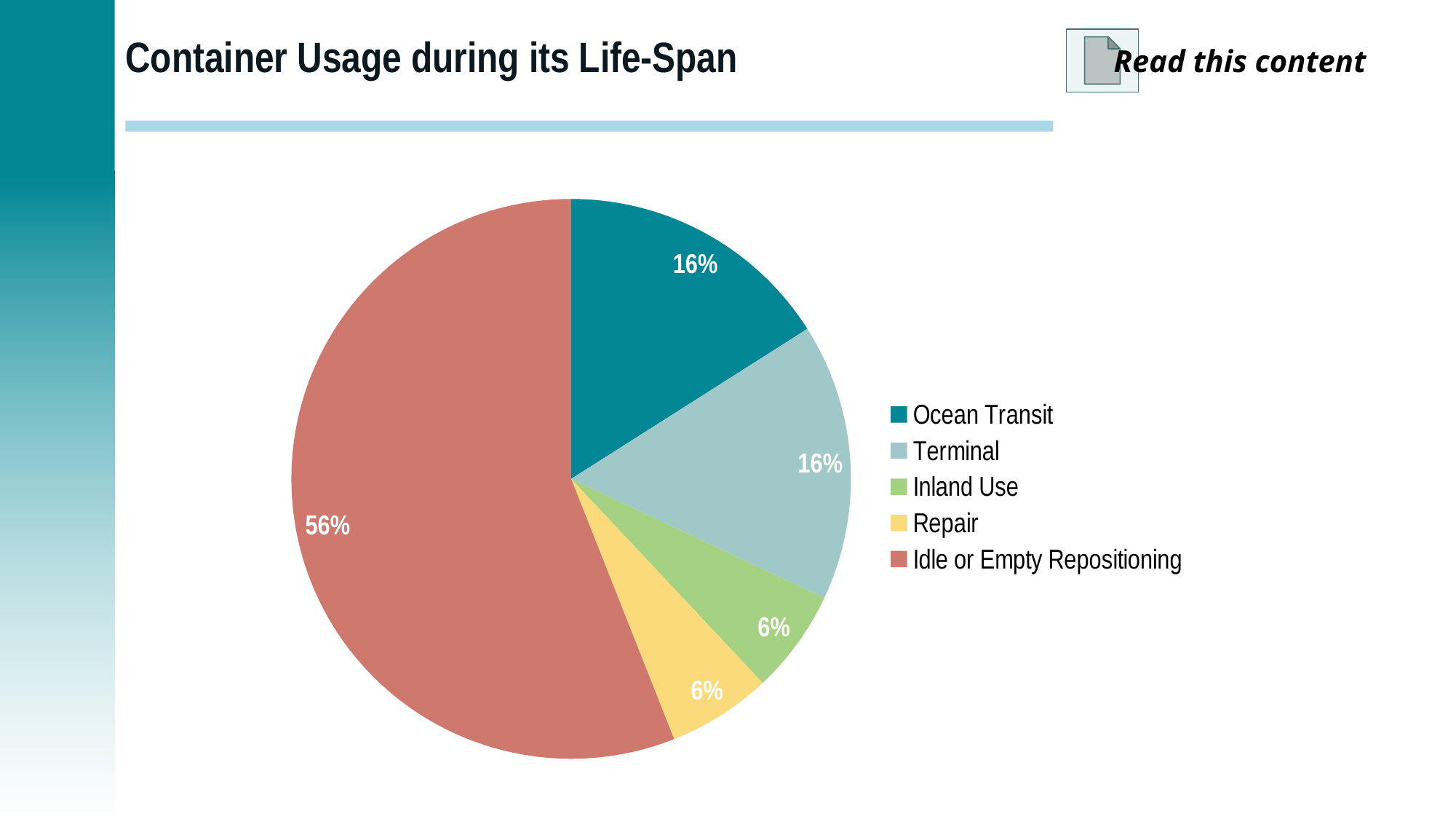
What share of container usage is Idle or Empty Repositioning? 56% How many categories does the pie chart show? 5 What kind of chart is shown on the slide? Pie chart Which is larger, the share for Ocean Transit or the share for Repair? Ocean Transit What share of container usage is Ocean Transit? 16% What is the title of the slide containing the chart? Container Usage during its Life-Span What share of container usage is Inland Use? 6% What share of container usage is Terminal? 16% What share of container usage is Repair? 6% What is the difference in percentage points between Idle or Empty Repositioning and Ocean Transit? 40 What is the difference in percentage points between Terminal and Inland Use? 10 Which category has the largest share of the pie? Idle or Empty Repositioning